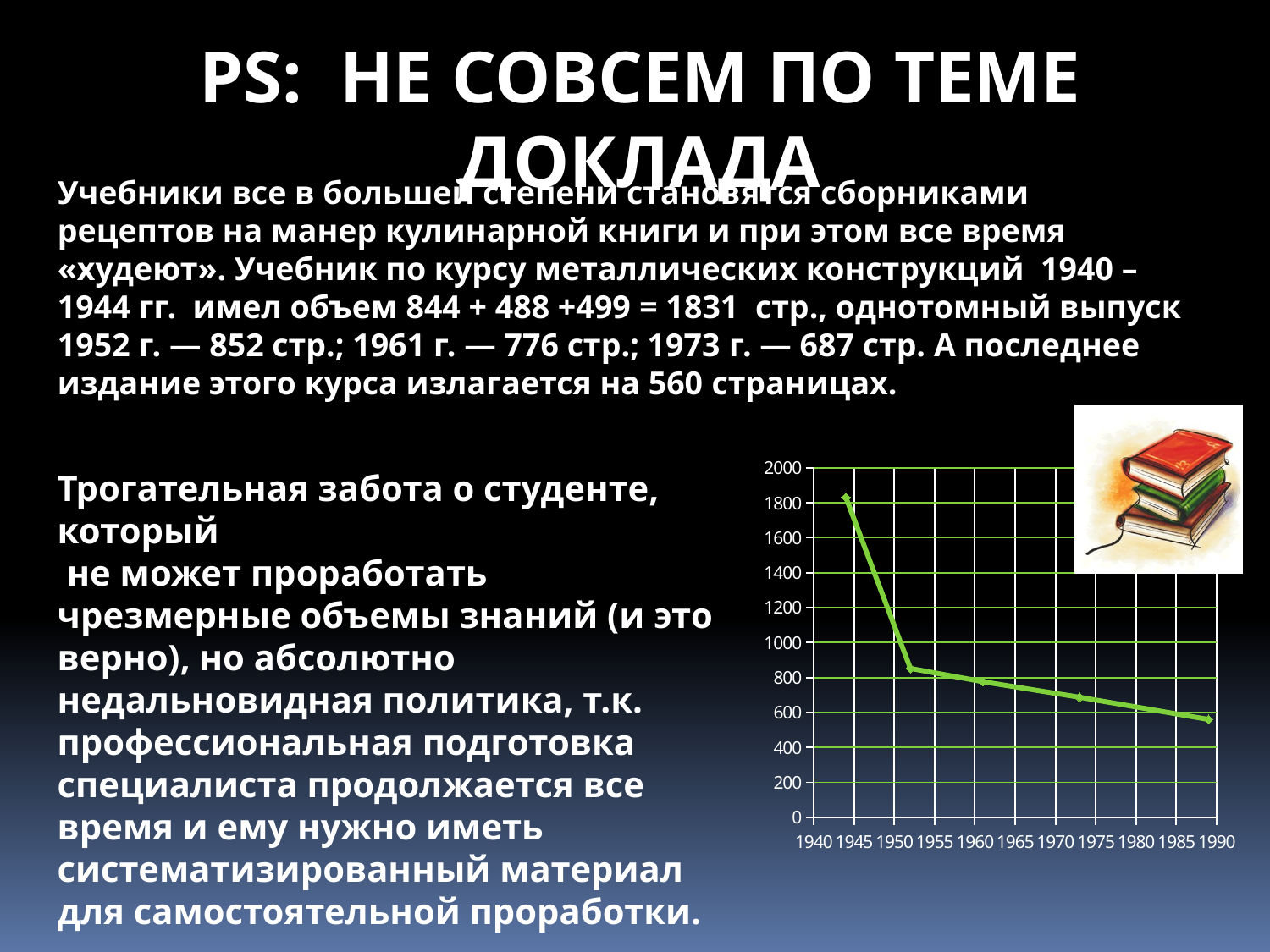
On the line chart, which is larger: the value around 1952 or the value at 1990? the value around 1952 Which plotted point on the line chart has the highest value? the first point (around 1944) Is the value of the last point on the line chart (1990) greater or less than 600? less Is the value of the point around 1952 on the line chart greater or less than 1000? less Which plotted point on the line chart has the lowest value? the last point (around 1989) Is the value of the point around 1973 on the line chart greater or less than 800? less What is the highest value shown on the vertical axis of the line chart? 2000 What kind of chart is shown on the slide? line chart Do the values on the line chart rise or fall as the years increase along the x axis? fall How many data points are plotted on the line chart? 5